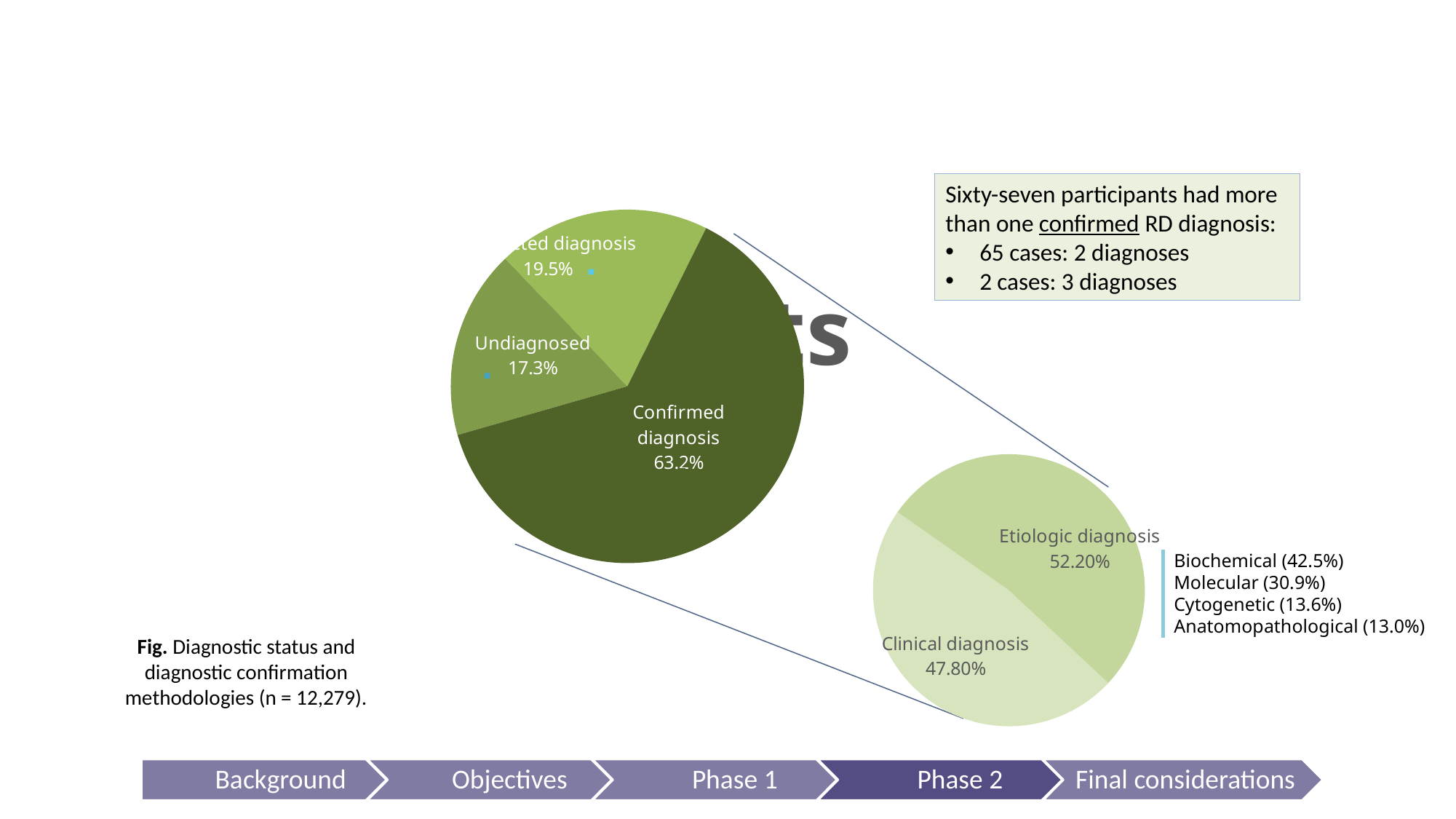
In the smaller pie chart, which category has the larger slice? Etiologic diagnosis In the larger pie chart, which category has the smallest slice? Undiagnosed In the larger pie chart, which category has the largest slice? Confirmed diagnosis In the larger pie chart, what percentage is shown for Confirmed diagnosis? 63.2% What type of chart is used to show the diagnostic status on this slide? Pie chart In the larger pie chart, which is larger: Confirmed diagnosis or Undiagnosed? Confirmed diagnosis In the smaller pie chart, what is the difference in percentage points between Etiologic diagnosis and Clinical diagnosis? 4.40 How many slices does the larger pie chart have? 3 In the smaller pie chart, what percentage is shown for Clinical diagnosis? 47.80% In the larger pie chart, what is the difference in percentage points between Confirmed diagnosis and Undiagnosed? 45.9 In the larger pie chart, what percentage is shown for Undiagnosed? 17.3% In the smaller pie chart, what percentage is shown for Etiologic diagnosis? 52.20%